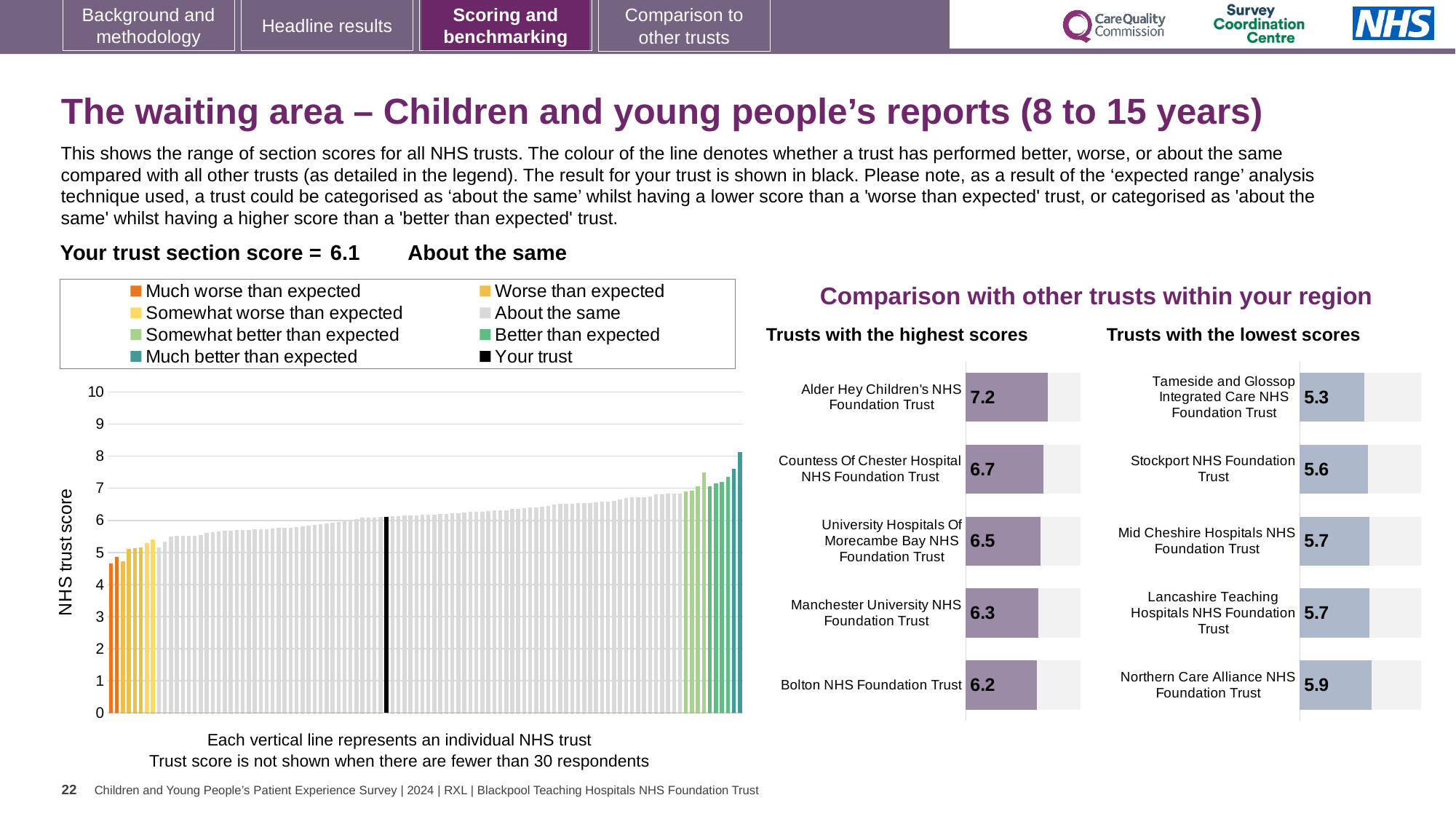
In the 'Trusts with the lowest scores' chart, what is the score for Stockport NHS Foundation Trust? 5.6 Which has the higher score: Countess Of Chester Hospital NHS Foundation Trust in the highest scores chart, or Stockport NHS Foundation Trust in the lowest scores chart? Countess Of Chester Hospital NHS Foundation Trust In the 'Trusts with the highest scores' chart, what is the difference between the scores of Alder Hey Children's NHS Foundation Trust and Bolton NHS Foundation Trust? 1.0 In the main 'NHS trust score' chart on the left, do the bar values rise or fall from left to right? rise In the 'Trusts with the lowest scores' chart, what is the difference between the scores of Northern Care Alliance NHS Foundation Trust and Tameside and Glossop Integrated Care NHS Foundation Trust? 0.6 In the main 'NHS trust score' chart on the left, is the value of the leftmost (lowest) bar greater or less than 5? less In the 'Trusts with the highest scores' chart, which trust has the lowest score? Bolton NHS Foundation Trust How many entries does the legend above the main 'NHS trust score' chart list? 8 How many trusts are shown in the 'Trusts with the highest scores' chart? 5 In the 'Trusts with the lowest scores' chart, which trust has the lowest score? Tameside and Glossop Integrated Care NHS Foundation Trust In the main 'NHS trust score' chart on the left, what is the section score for your trust (the black bar)? 6.1 In the 'Trusts with the highest scores' chart, what is the score for Alder Hey Children's NHS Foundation Trust? 7.2